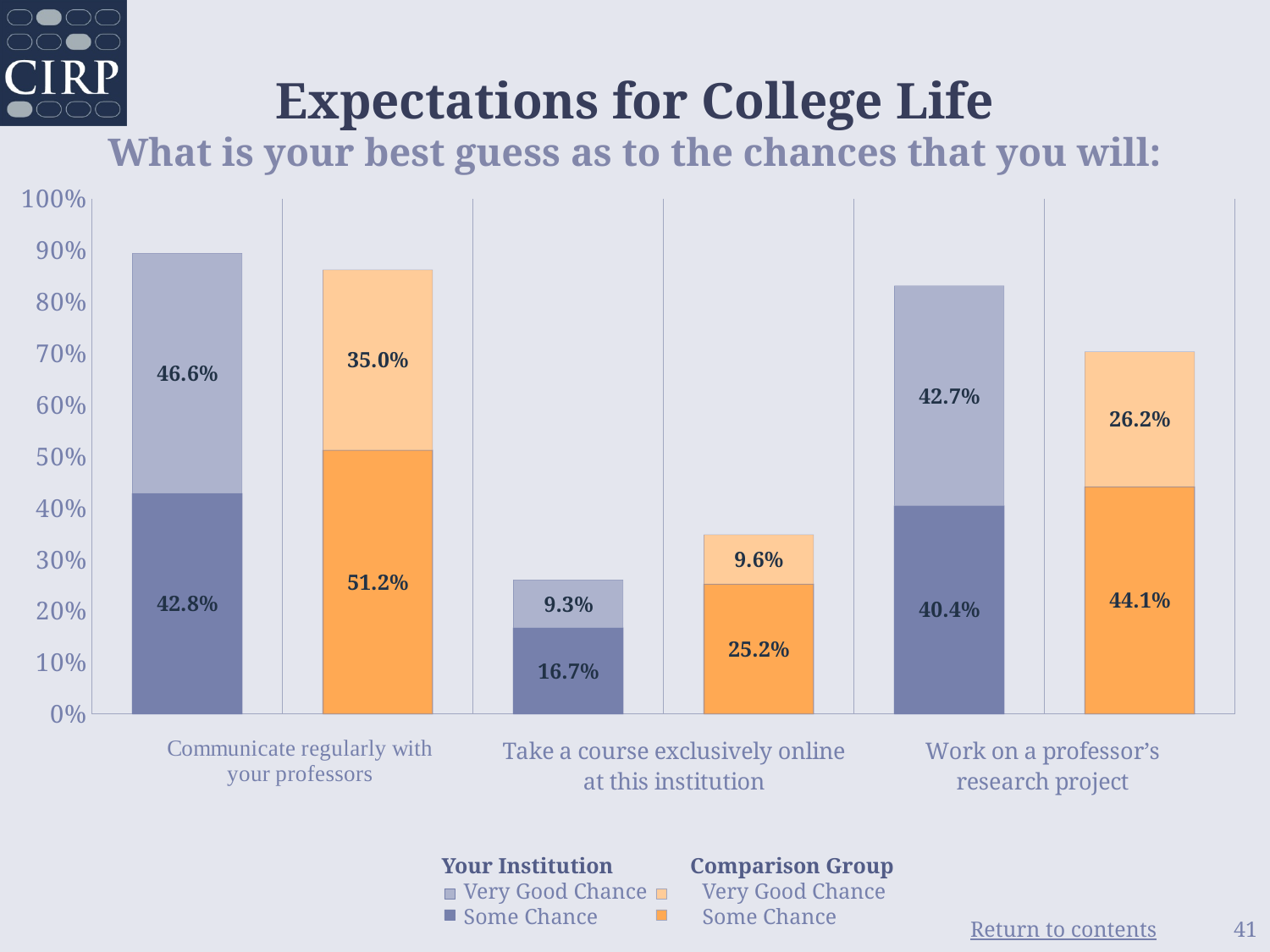
What is the difference between the Comparison Group's Some Chance value and Your Institution's Some Chance value for 'Communicate regularly with your professors'? 8.4% What percentage of Your Institution students say there is Some Chance they will work on a professor's research project? 40.4% Which category has the lowest total stacked bar for Your Institution? Take a course exclusively online at this institution Is the total stacked bar for the Comparison Group for 'Take a course exclusively online at this institution' greater or less than 40%? less What percentage of the Comparison Group say there is Some Chance they will take a course exclusively online at this institution? 25.2% For 'Work on a professor's research project', which group has the larger Very Good Chance value, Your Institution or the Comparison Group? Your Institution How many categories are shown on the x axis of the chart? 3 What percentage of Your Institution students say there is a Very Good Chance they will communicate regularly with their professors? 46.6% What is the total stacked bar value for the Comparison Group for 'Work on a professor's research project'? 70.3% What kind of chart is shown on the slide? Stacked bar chart What is the total stacked bar value for Your Institution for 'Communicate regularly with your professors'? 89.4% How many series does the legend list? 4